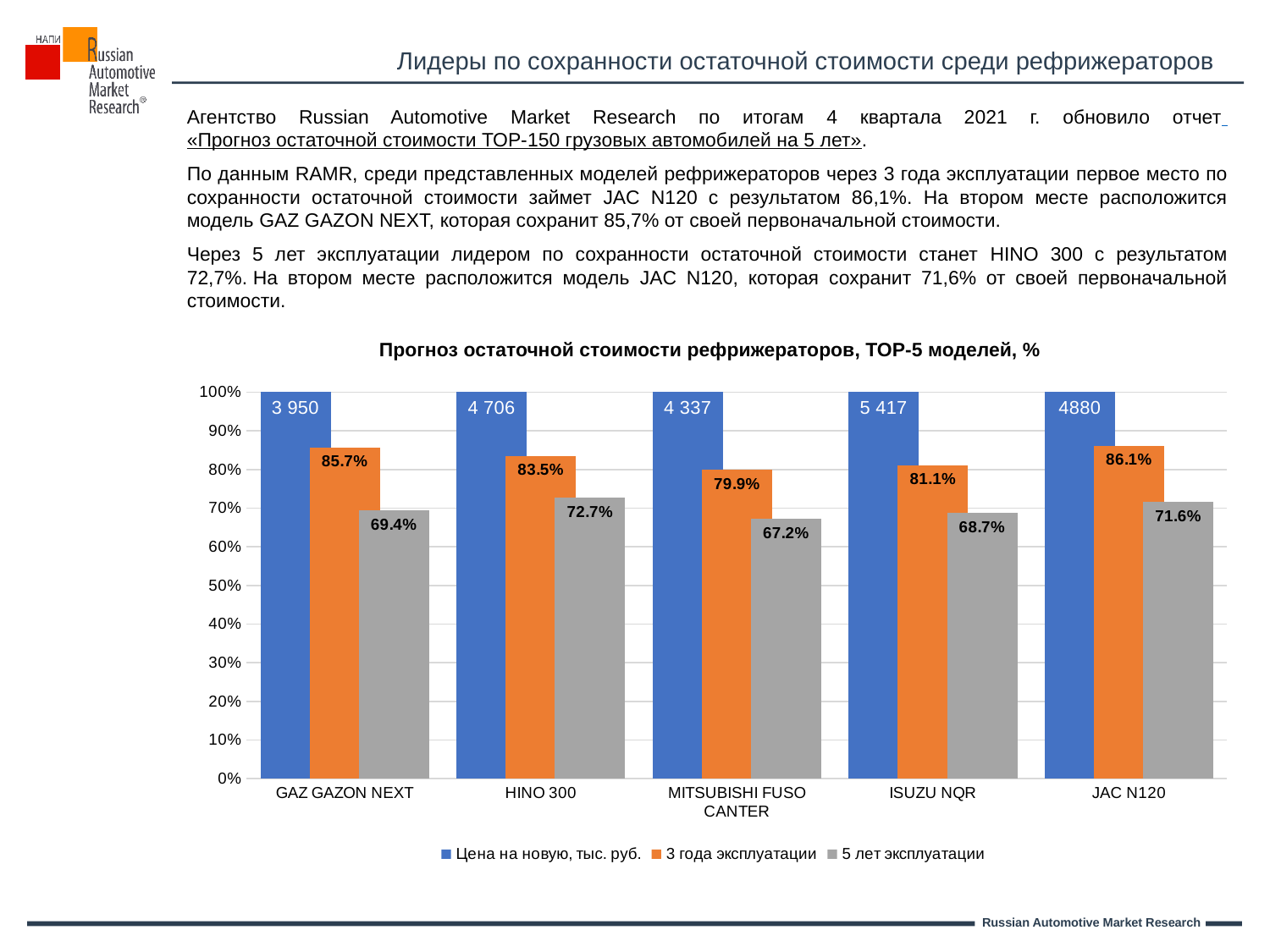
Which model has the lowest value after 5 years of operation? MITSUBISHI FUSO CANTER What is the difference between the 3-year and 5-year values for GAZ GAZON NEXT? 16.3% Which colour represents the series '5 лет эксплуатации' in the chart? grey Which is larger: the 5-year value for ISUZU NQR or the 5-year value for GAZ GAZON NEXT? GAZ GAZON NEXT How many series does the chart legend list? 3 What is the value for HINO 300 after 5 years of operation (5 лет эксплуатации)? 72.7% Which model has the highest value after 3 years of operation? JAC N120 How many models are shown on the x axis of the chart? 5 What is the price of a new ISUZU NQR (Цена на новую, тыс. руб.) shown on the chart? 5 417 What is the title of the chart? Прогноз остаточной стоимости рефрижераторов, ТОР-5 моделей, % What kind of chart is shown on the slide? bar chart What is the value for JAC N120 after 3 years of operation (3 года эксплуатации)? 86.1%